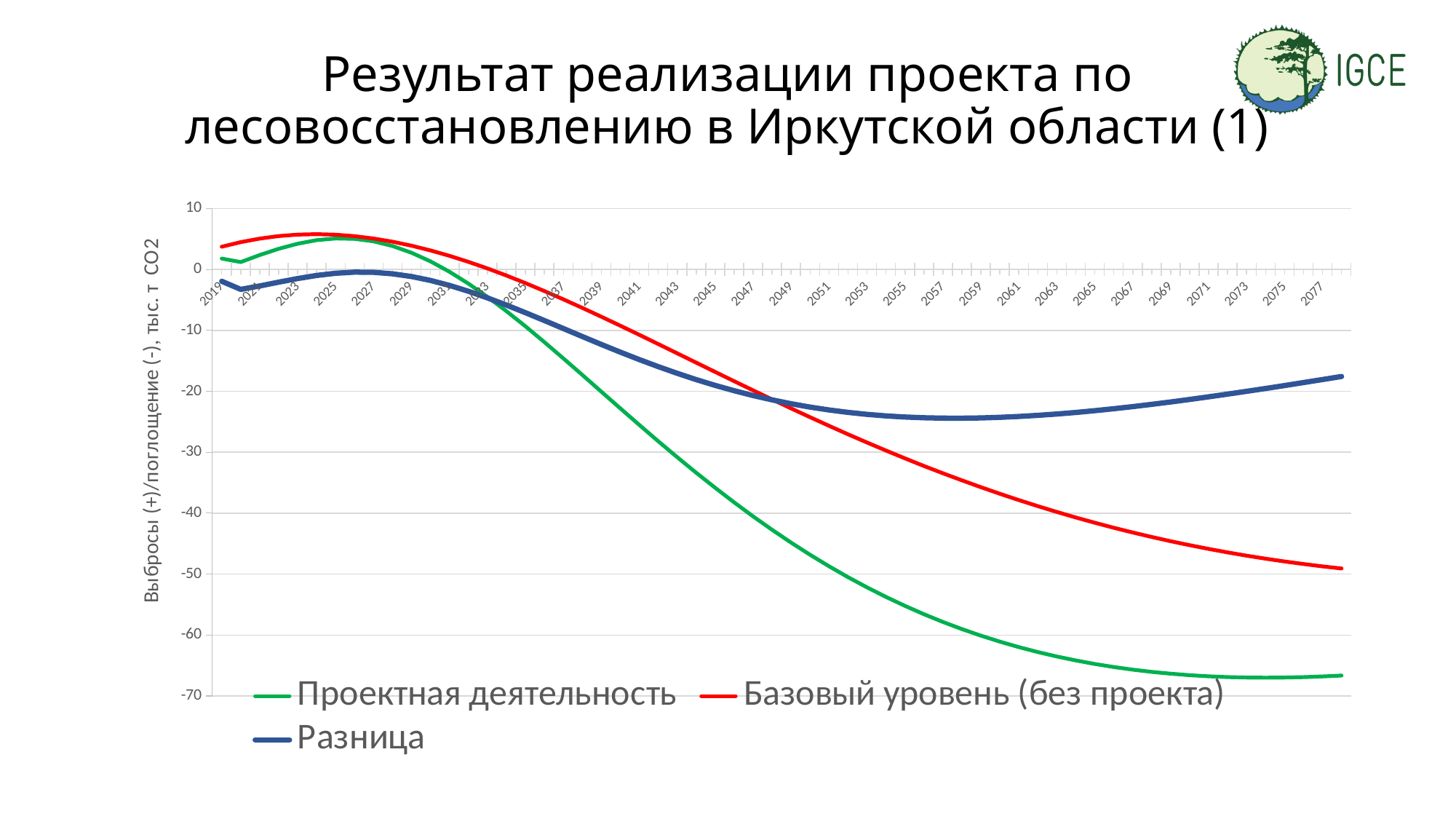
Is the value of the Базовый уровень (без проекта) series in 2077 greater or less than -40? less Is the value of the Проектная деятельность series in 2077 greater or less than -60? less What is the label of the vertical axis? Выбросы (+)/поглощение (-), тыс. т CO2 What kind of chart is shown on the slide? Line chart Which series has the highest value in 2077? Разница Which series is drawn in green according to the legend? Проектная деятельность Is the value of the Разница series in 2057 greater or less than -20? less In 2045, which series has the lower value: Проектная деятельность or Базовый уровень (без проекта)? Проектная деятельность Which series has the lowest value in 2077? Проектная деятельность Does the Базовый уровень (без проекта) series rise or fall from 2031 to 2077? Fall How many series does the chart legend list? 3